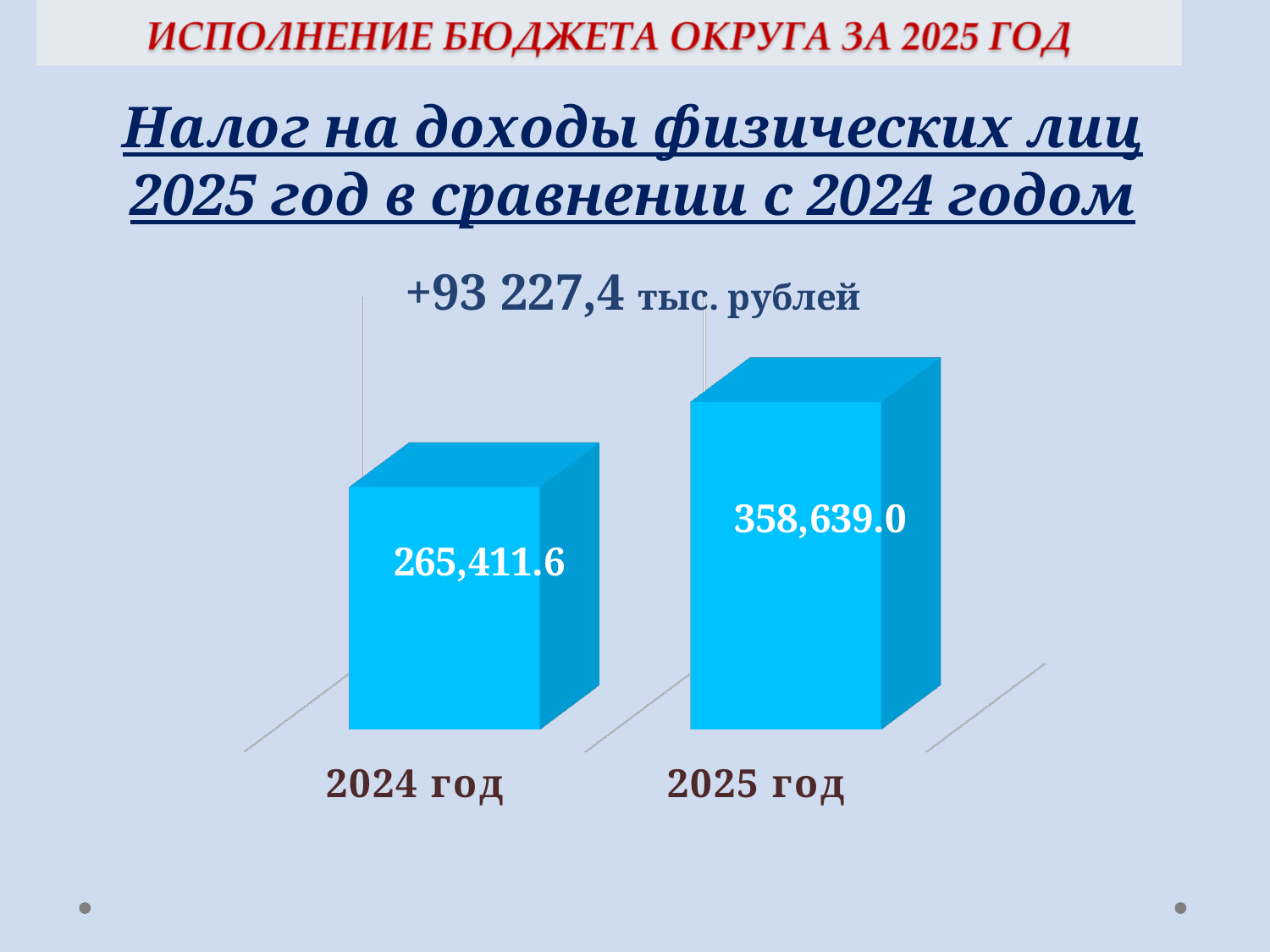
How many bars are shown in the chart? 2 Do the values rise or fall from 2024 год to 2025 год? rise Which year has the higher value? 2025 год What colour are the bars in the chart? blue By how much does the value for 2025 год exceed the value for 2024 год? 93 227,4 тыс. рублей What kind of chart is shown on the slide? bar chart What is the title of the chart on the slide? Налог на доходы физических лиц 2025 год в сравнении с 2024 годом What is the value for 2024 год? 265,411.6 Which year has the lower value? 2024 год Is the value for 2025 год larger or smaller than the value for 2024 год? larger What is the value for 2025 год? 358,639.0